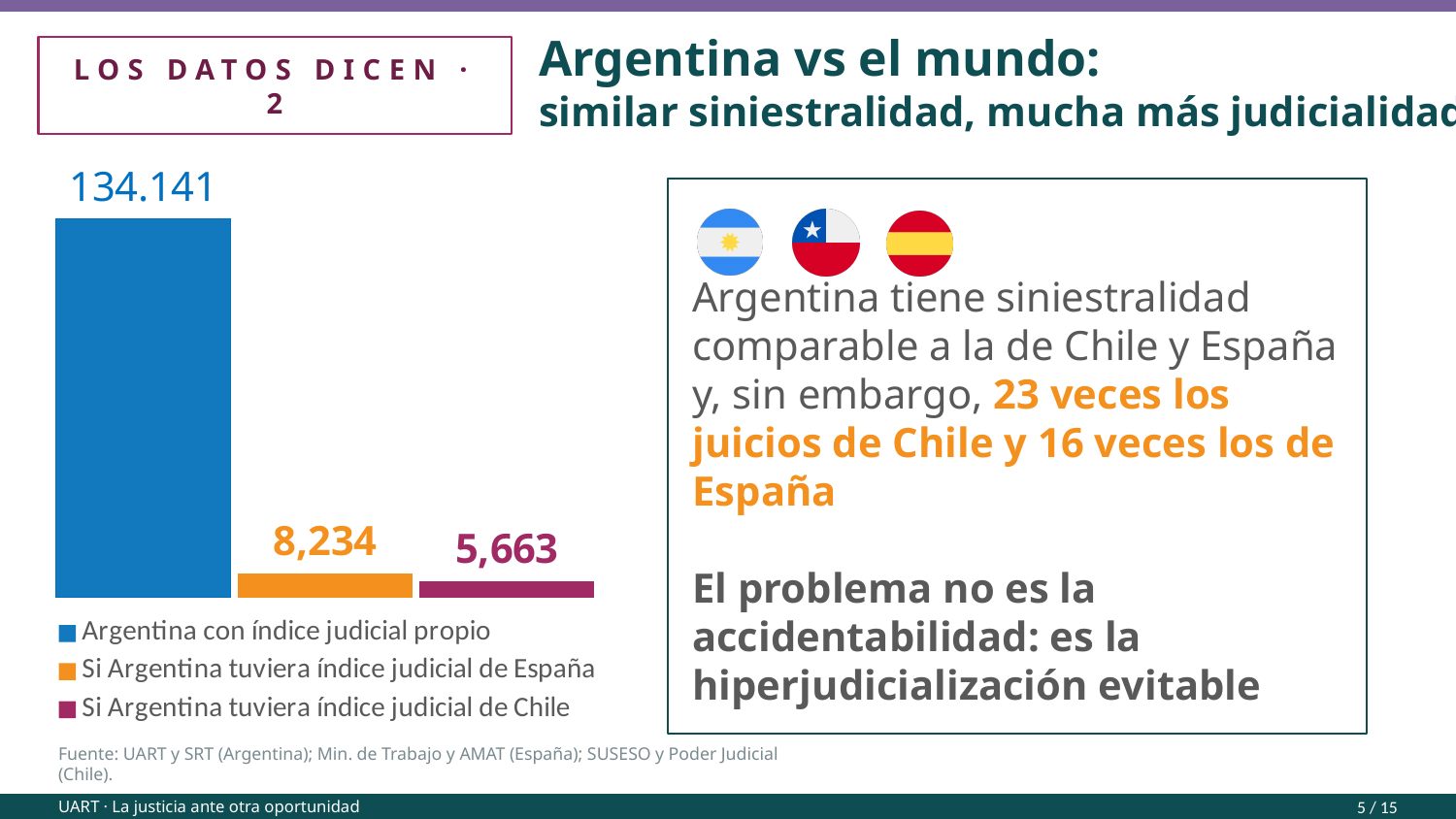
What is the value shown for 'Si Argentina tuviera índice judicial de España'? 8,234 How many series does the legend list? 3 What is the difference between the value for 'Si Argentina tuviera índice judicial de España' and the value for 'Si Argentina tuviera índice judicial de Chile'? 2,571 Which is larger: the value for 'Si Argentina tuviera índice judicial de España' or the value for 'Si Argentina tuviera índice judicial de Chile'? Si Argentina tuviera índice judicial de España What colour is the bar for 'Argentina con índice judicial propio'? Blue What is the value shown for 'Si Argentina tuviera índice judicial de Chile'? 5,663 Which series has the highest value in the chart? Argentina con índice judicial propio What kind of chart is shown on the slide? Bar chart How many bars are plotted in the chart? 3 Which series has the lowest value in the chart? Si Argentina tuviera índice judicial de Chile Which legend entry is shown in orange? Si Argentina tuviera índice judicial de España What is the value shown for 'Argentina con índice judicial propio'? 134.141